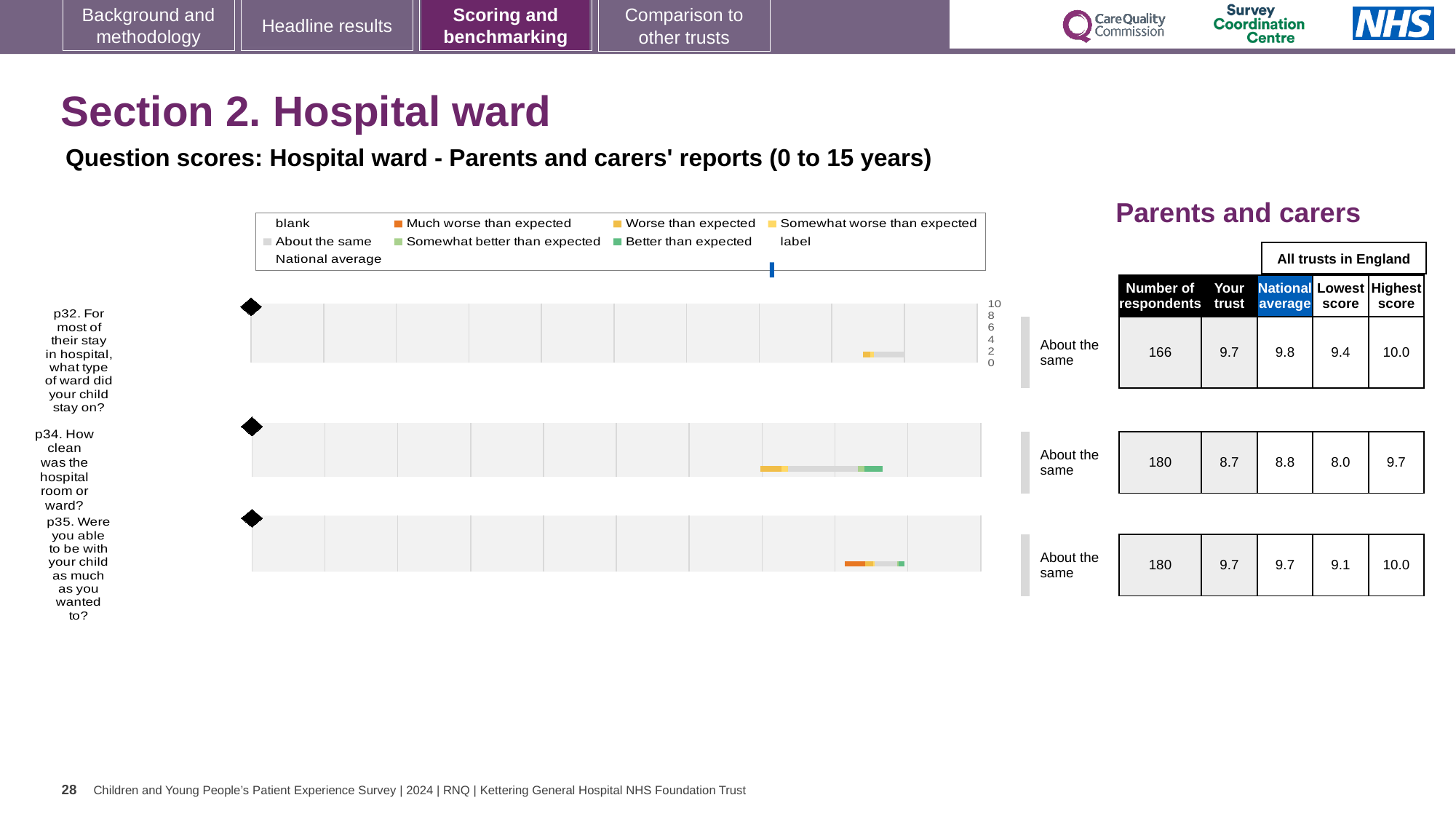
What is the difference between the highest score and the lowest score for p34? 1.7 How many questions (p32, p34, p35) are plotted on this slide? 3 What is the 'Your trust' score for p32 (what type of ward did your child stay on)? 9.7 What is the national average for p34 (how clean was the hospital room or ward)? 8.8 What type of chart is used for the question scores on this slide? bar chart Which legend entry is shown in orange? Much worse than expected How many entries does the chart legend list? 9 What is the number of respondents for p35 (were you able to be with your child as much as you wanted to)? 180 Is the 'Your trust' score for p34 larger or smaller than the national average for p34? smaller What is the lowest score across all trusts in England for p32? 9.4 What is the benchmark category shown for p35? About the same Which of the three questions has the lowest 'Your trust' score? p34